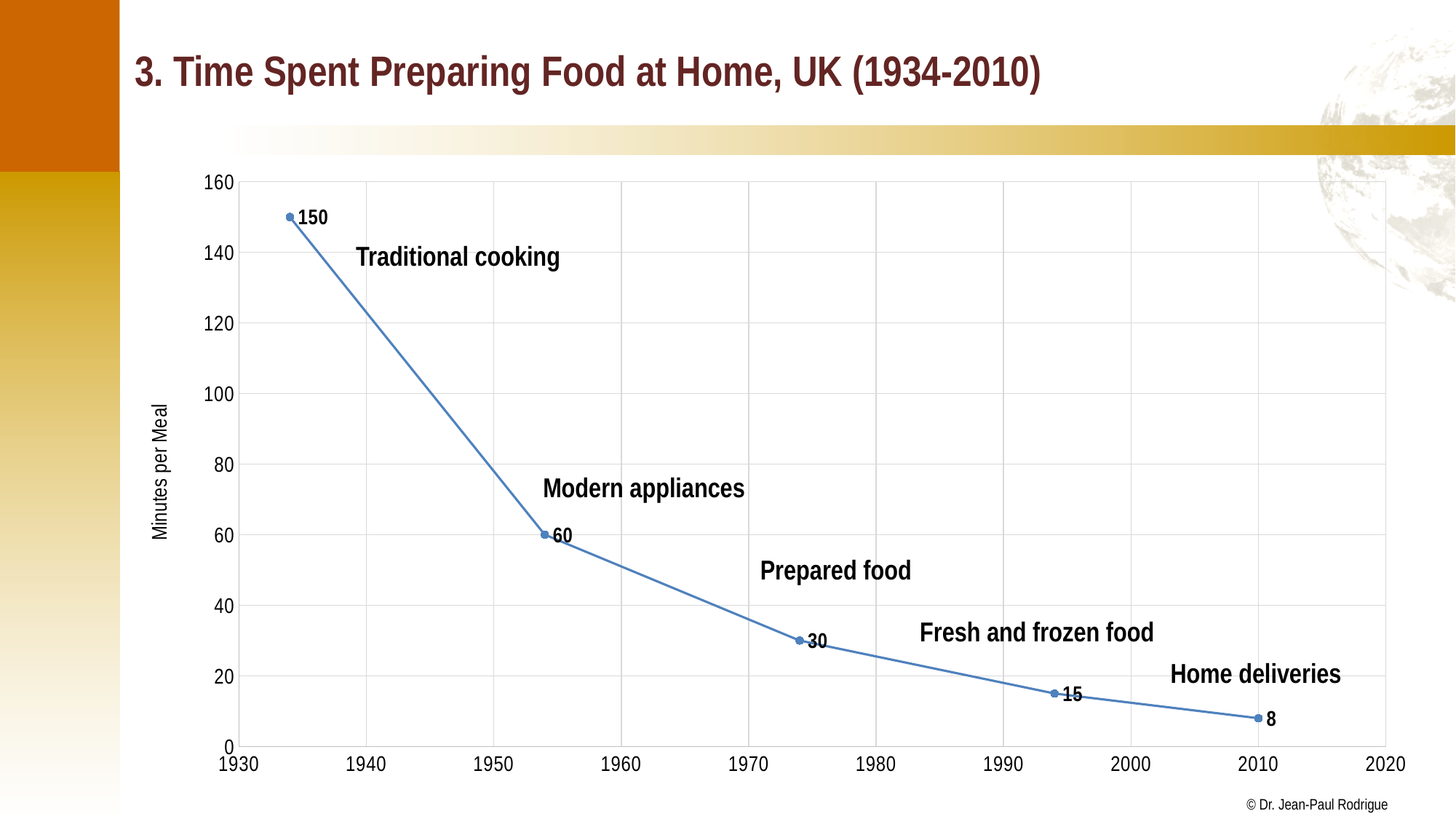
Which data point has the lowest value? Home deliveries (8) What kind of chart is shown on the slide? Line chart How many data points are plotted on the line? 5 What is the label of the y axis? Minutes per Meal What is the value of the data point labelled Fresh and frozen food? 15 What is the value of the data point labelled Prepared food? 30 Do the values rise or fall over time along the x axis? Fall What is the difference between the Traditional cooking value and the Modern appliances value? 90 Which data point has the highest value? Traditional cooking (150) What is the value of the first data point, labelled Traditional cooking? 150 What is the value of the data point labelled Modern appliances? 60 What is the value of the last data point, labelled Home deliveries? 8